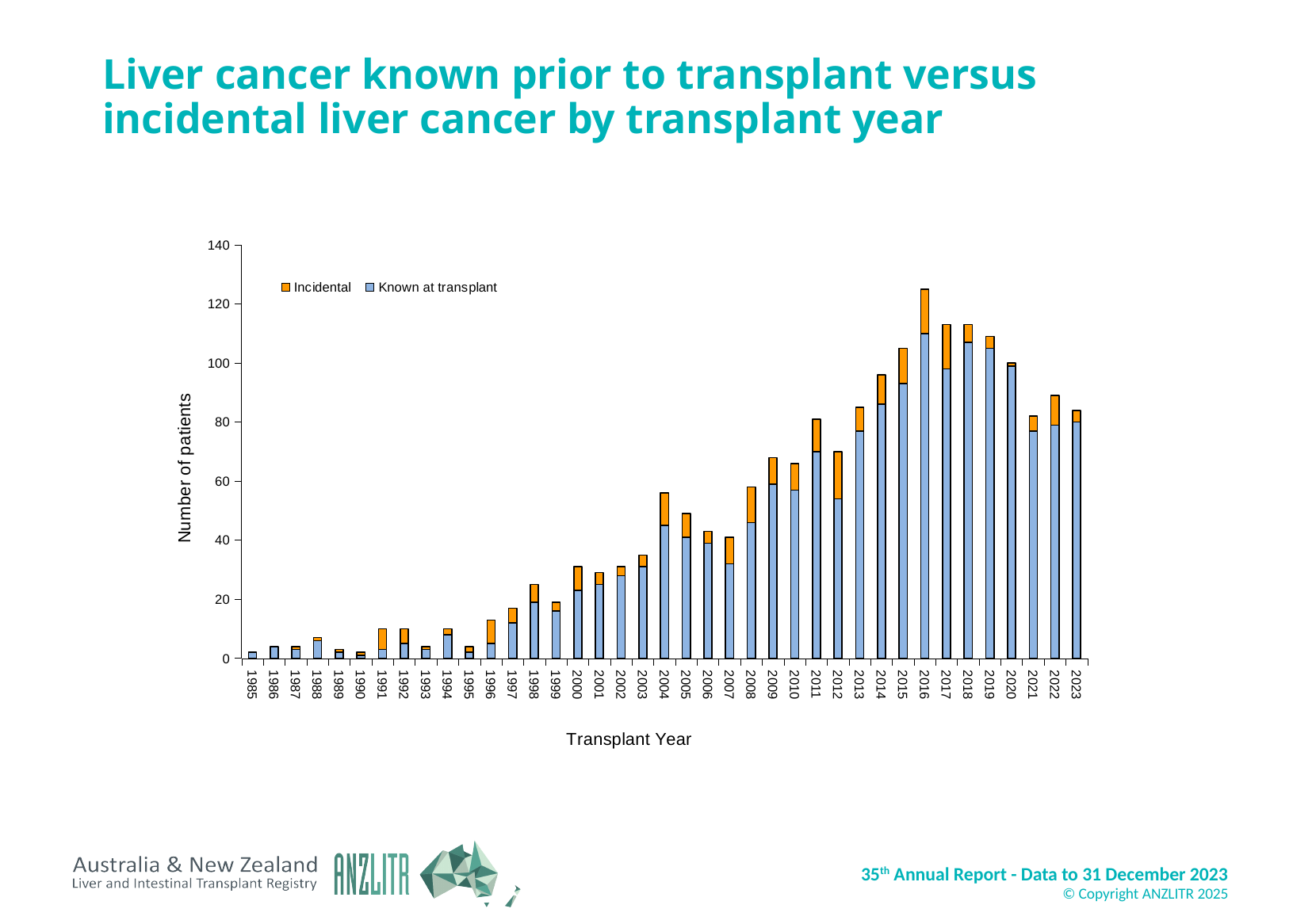
What are the two series named in the legend? Incidental and Known at transplant Is the total number of patients for 2021 greater or less than 100? less Is the total number of patients for 2004 greater or less than 40? greater What is the label on the y axis? Number of patients Which transplant year has the tallest bar (highest total number of patients)? 2016 Which year has the larger total number of patients, 2011 or 2012? 2011 Is the total number of patients for 2012 greater or less than 80? less How many series does the legend list? 2 Do the total numbers of patients generally rise or fall from 2016 to 2021? fall What kind of chart is shown on the slide? Stacked bar chart How many transplant years are shown on the x axis? 39